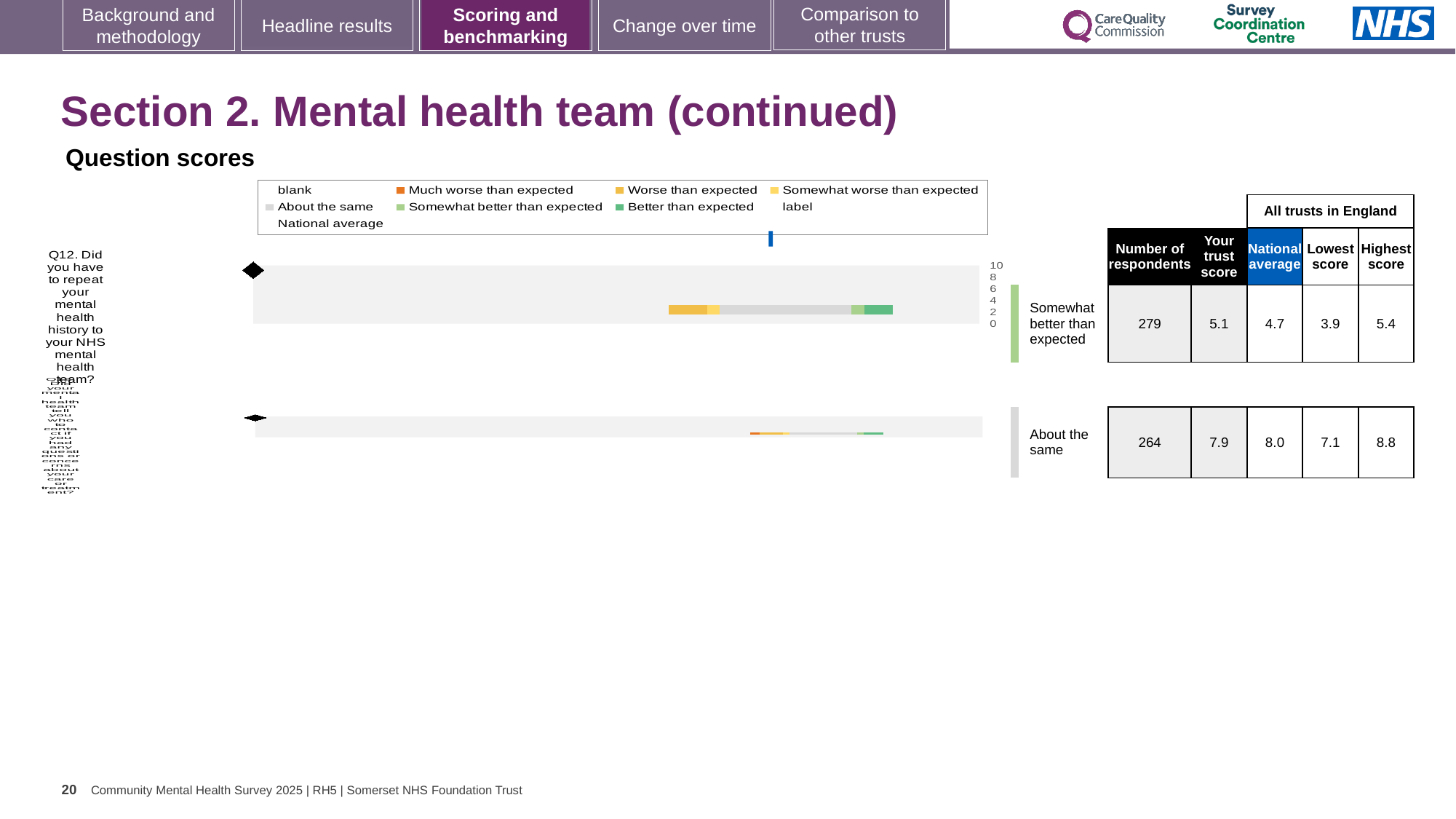
What is the highest score among all trusts in England for Q12? 5.4 What is the maximum value shown on the chart's score axis? 10 What is the lowest score among all trusts in England for Q12? 3.9 What is the national average score for Q12? 4.7 What is the difference between the trust score and the national average for Q12? 0.4 What is the trust score for Q12 (repeating your mental health history to your NHS mental health team)? 5.1 Which colour in the legend represents 'Much worse than expected'? orange For Q12, is the trust score higher or lower than the national average? higher How many respondents answered Q12? 279 Which benchmarking category does the trust's Q12 score fall into? Somewhat better than expected What kind of chart is used to show the question scores? bar chart